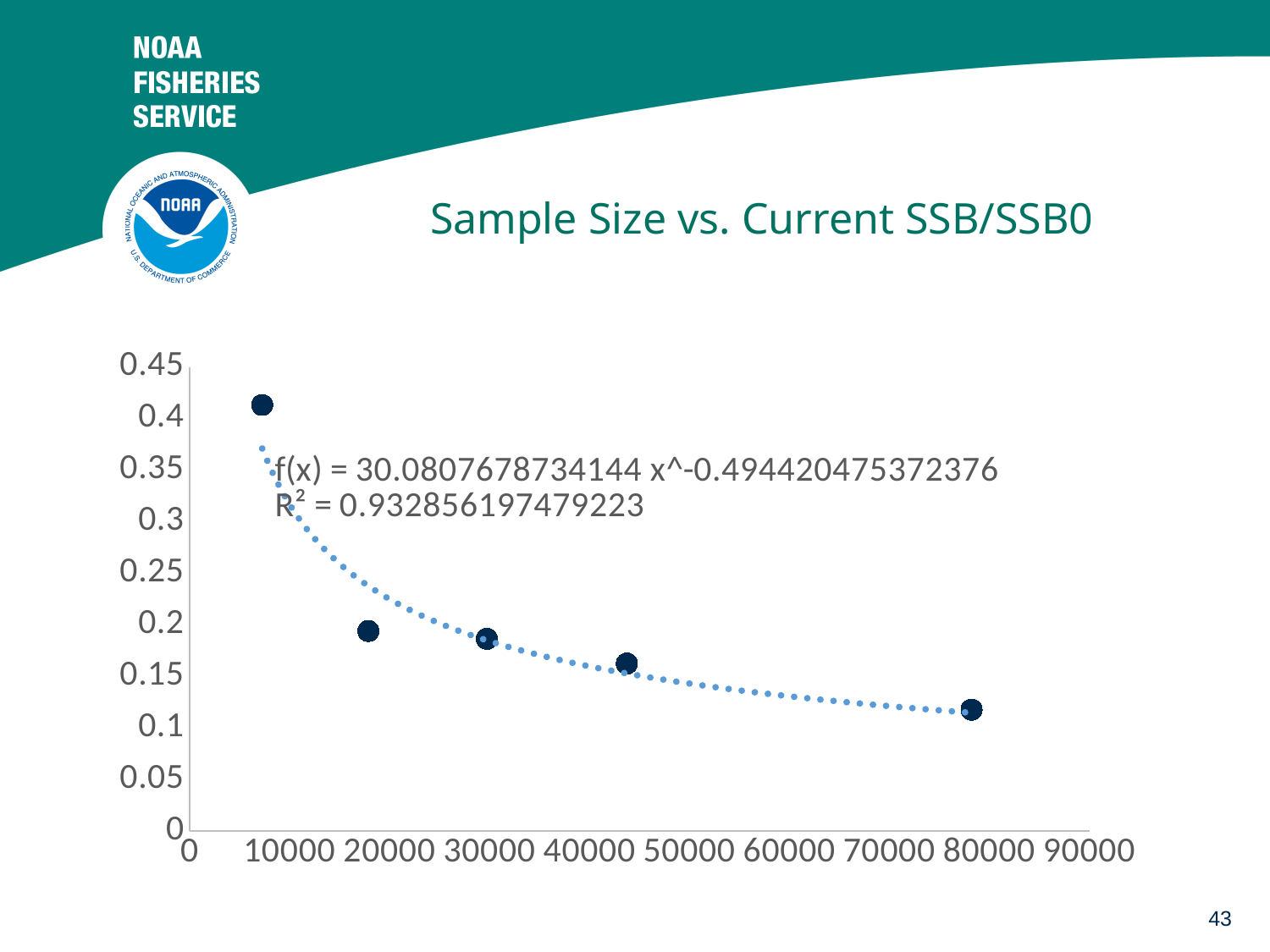
What is the title of the chart? Sample Size vs. Current SSB/SSB0 How many data points are plotted on the chart? 5 What R² value is shown for the trendline on the chart? 0.932856197479223 Is the y value of the leftmost data point greater or less than 0.35? greater Is the y value of the data point near a sample size of 20000 greater or less than 0.25? less What kind of chart is shown on the slide? scatter chart Which has the larger y value: the data point near a sample size of 10000 or the data point near 30000? the data point near 10000 Which data point has the lowest y value: the leftmost point or the rightmost point? the rightmost point Do the plotted values rise or fall as sample size increases along the x axis? fall Which data point has the highest y value: the one with the smallest sample size or the one with the largest sample size? the one with the smallest sample size Is the y value of the rightmost data point (near 80000) greater or less than 0.15? less